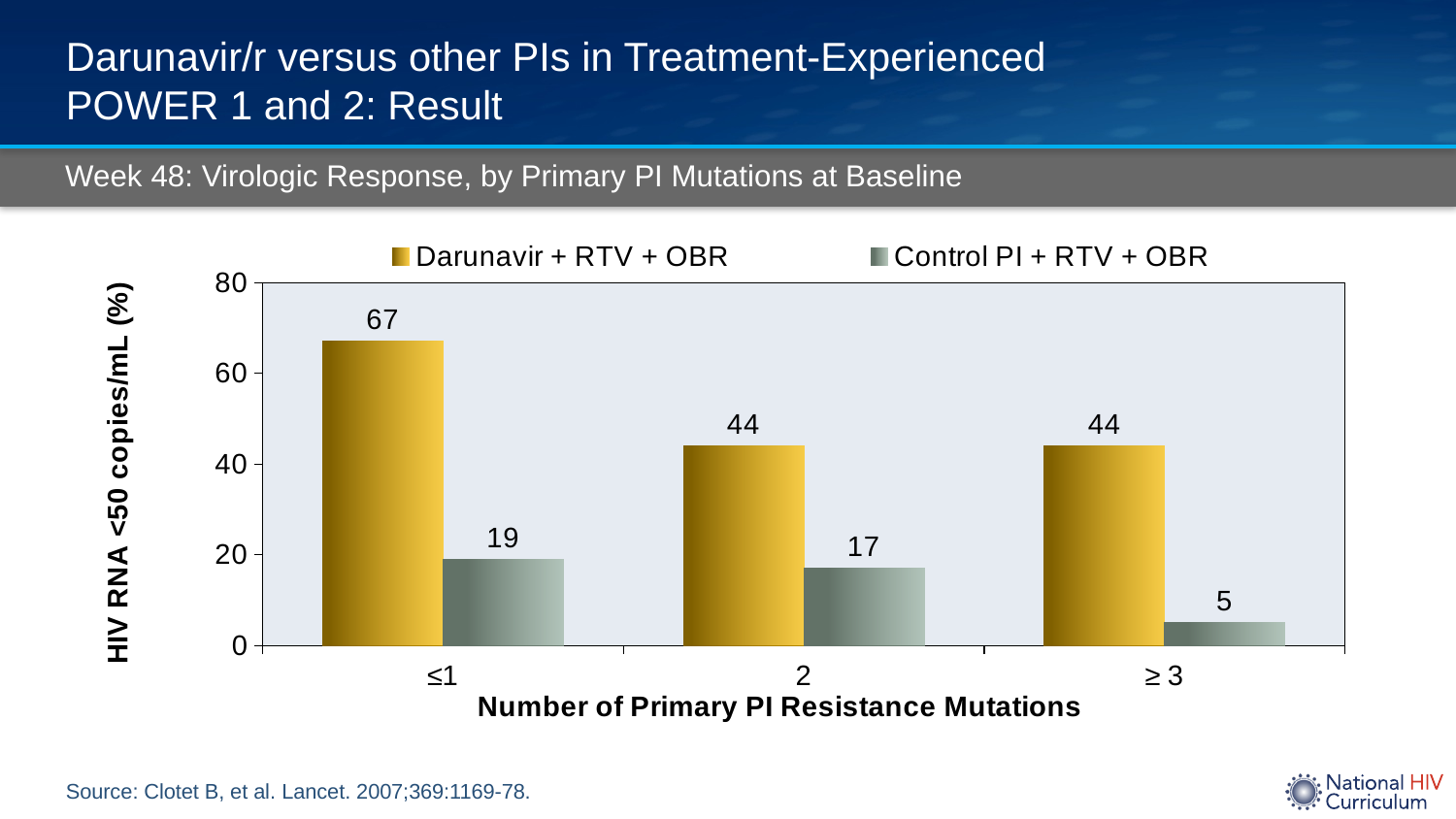
How many series does the legend list? 2 What is the value for Control PI + RTV + OBR in the 2 primary PI resistance mutations category? 17 What is the value for Darunavir + RTV + OBR in the ≤1 primary PI resistance mutations category? 67 In the 2 mutations category, which series has the larger value, Darunavir + RTV + OBR or Control PI + RTV + OBR? Darunavir + RTV + OBR What is the label of the y axis? HIV RNA <50 copies/mL (%) What is the value for Control PI + RTV + OBR in the ≥ 3 primary PI resistance mutations category? 5 What kind of chart is shown on the slide? Bar chart How many categories are shown on the x axis? 3 What is the difference between the Darunavir + RTV + OBR and Control PI + RTV + OBR values in the ≤1 category? 48 Which category has the lowest value for Control PI + RTV + OBR? ≥ 3 What is the difference between the Darunavir + RTV + OBR and Control PI + RTV + OBR values in the ≥ 3 category? 39 Which category has the highest value for Darunavir + RTV + OBR? ≤1